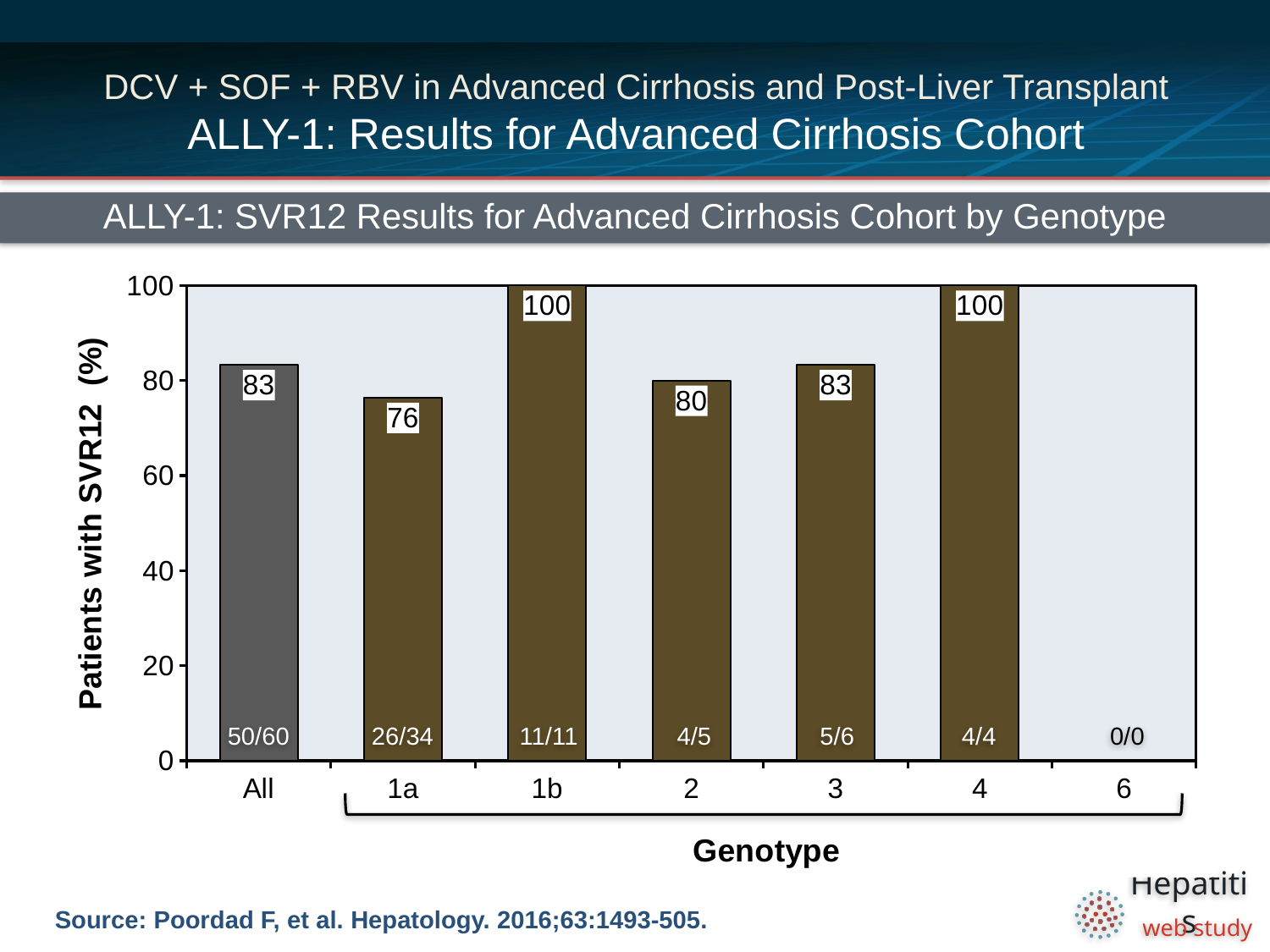
How many categories are shown on the x axis? 7 What is the SVR12 rate for genotype 2? 80 Which genotype has the lowest SVR12 rate among those with a plotted bar? 1a How many patients achieved SVR12 out of the total in genotype 1b, as shown at the base of the bar? 11/11 What fraction is shown at the base of the bar for the All group? 50/60 Is the SVR12 rate for genotype 1a greater or less than 80? less What kind of chart is shown on the slide? Bar chart What is the SVR12 rate for genotype 1a? 76 Which has a higher SVR12 rate, genotype 2 or genotype 3? Genotype 3 What is the SVR12 rate for the All group? 83 What is the difference in SVR12 rate between genotype 1b and genotype 1a? 24 What is the label of the y axis? Patients with SVR12 (%)